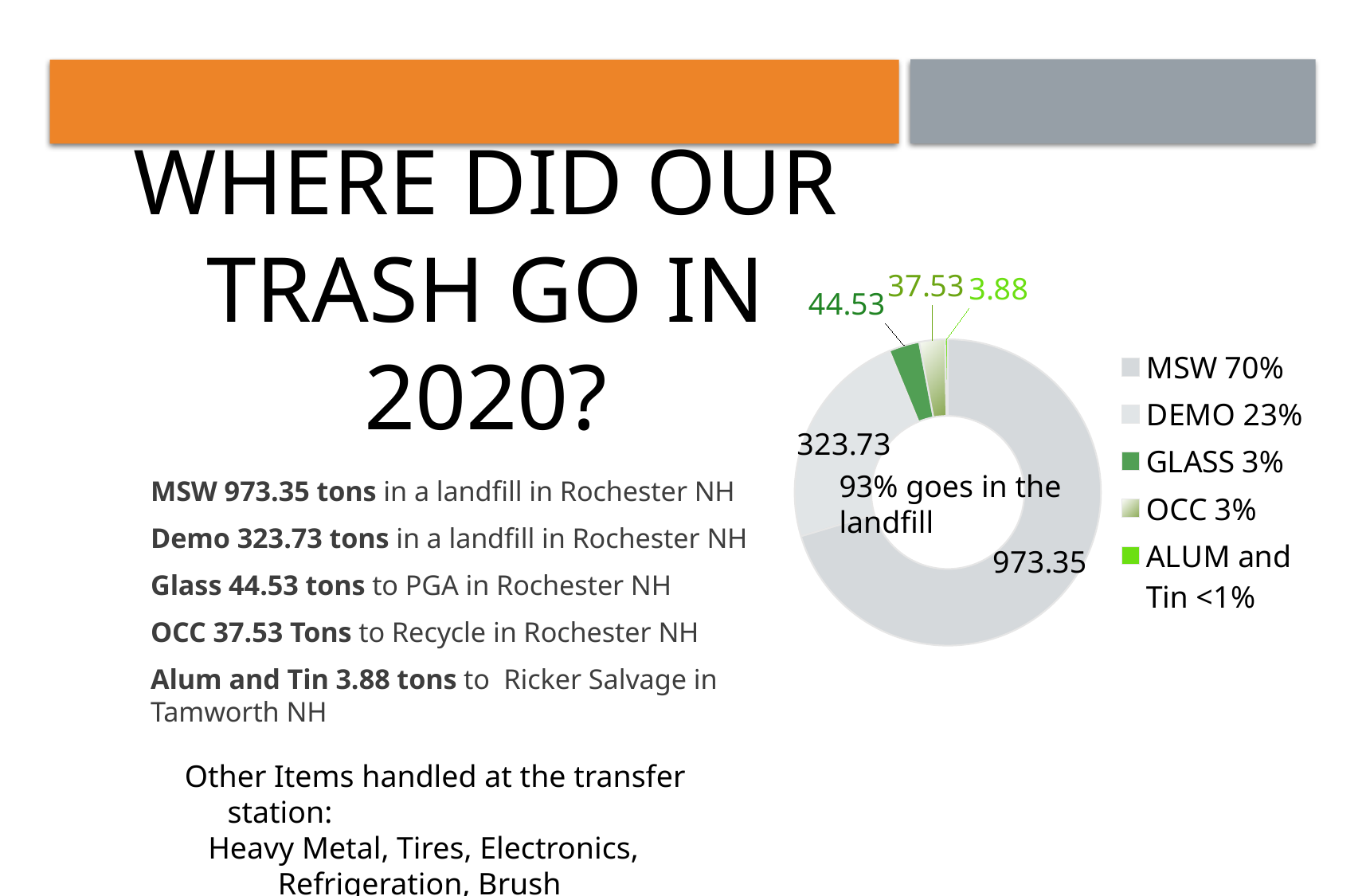
What is the value shown for GLASS on the chart? 44.53 What is the value shown for ALUM and Tin on the chart? 3.88 What type of chart is shown on the slide? doughnut chart Which is larger, the value for GLASS or the value for OCC? GLASS What is the value shown for DEMO on the chart? 323.73 What is the value shown for MSW on the chart? 973.35 What is the difference between the MSW value and the DEMO value? 649.62 How many categories does the chart's legend list? 5 What share of the chart does DEMO represent according to the legend? 23% Which category has the smallest slice of the chart? ALUM and Tin Which category has the largest slice of the chart? MSW What is the value shown for OCC on the chart? 37.53